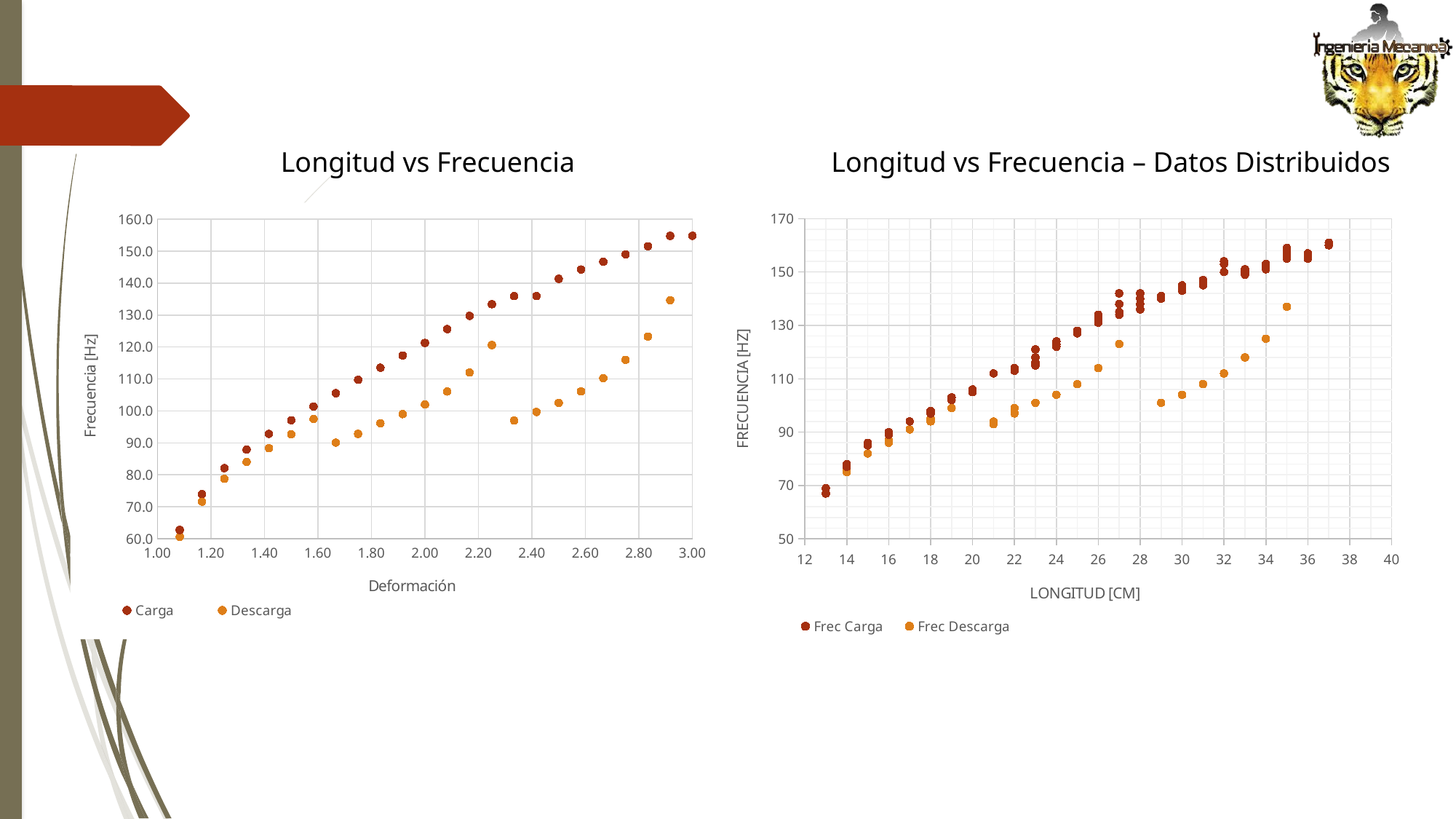
What is the x-axis label of the left chart "Longitud vs Frecuencia"? Deformación How many series does the legend of the left chart "Longitud vs Frecuencia" list? 2 How many series does the legend of the right chart "Longitud vs Frecuencia – Datos Distribuidos" list? 2 What kind of chart is the left chart titled "Longitud vs Frecuencia"? Scatter chart In the right chart "Longitud vs Frecuencia – Datos Distribuidos", at 34 cm, which series has the larger value, Frec Carga or Frec Descarga? Frec Carga In the right chart "Longitud vs Frecuencia – Datos Distribuidos", is the Frec Carga value at 37 cm greater or less than 150? greater In the left chart "Longitud vs Frecuencia", at Deformación 2.50, which series has the larger value, Carga or Descarga? Carga What is the title of the right chart? Longitud vs Frecuencia – Datos Distribuidos In the left chart "Longitud vs Frecuencia", is the Carga value at Deformación 3.00 greater or less than 150.0? greater In the left chart "Longitud vs Frecuencia", do the Carga values rise or fall as Deformación increases? Rise